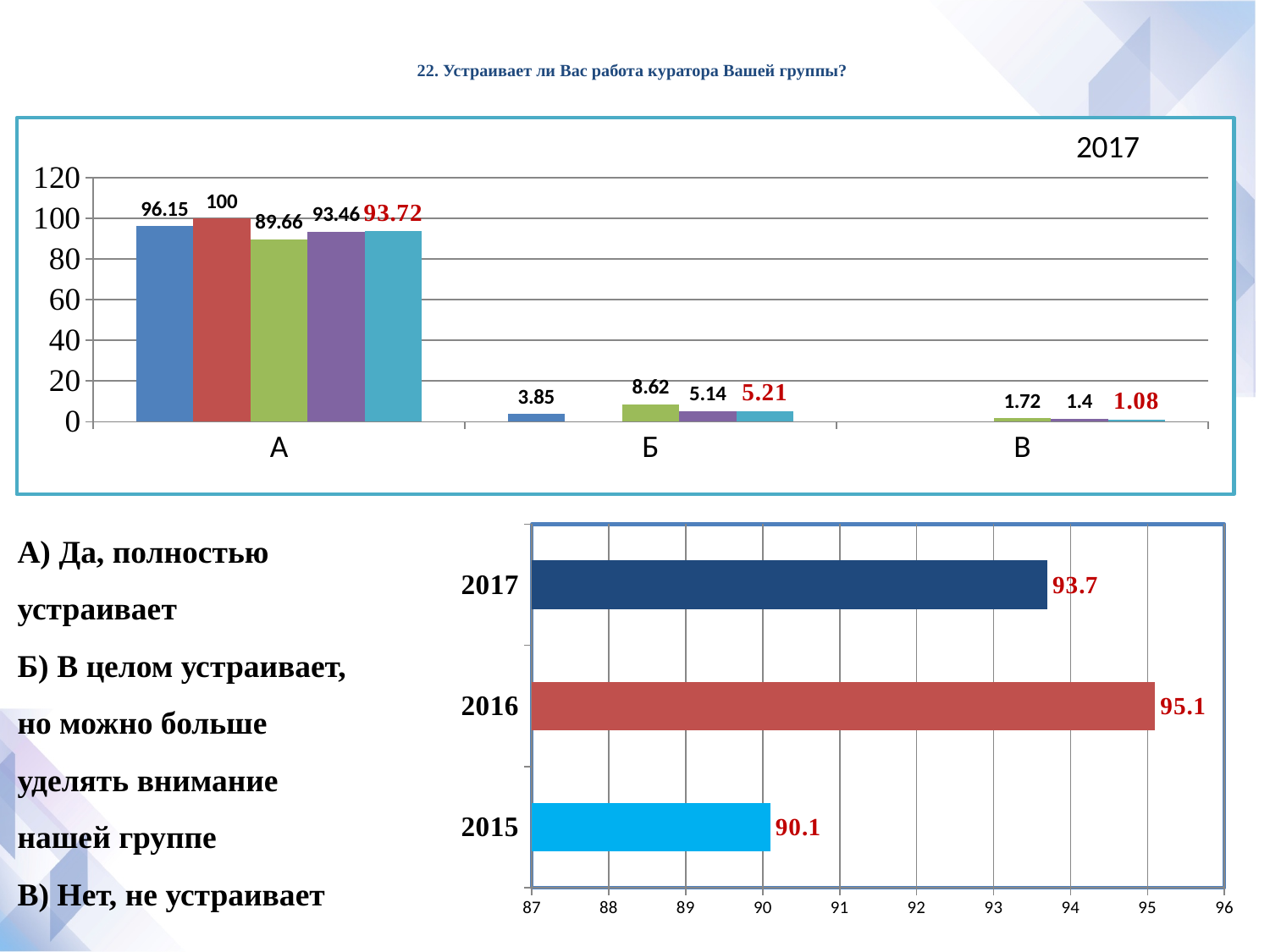
In the top chart, what is the highest value shown for category А? 100 In the top chart, how many categories are shown on the x axis? 3 What kind of chart is the bottom chart? bar chart In the bottom chart, how many years are shown? 3 In the bottom chart, which year has the highest value? 2016 In the top chart, what is the lowest value shown for category В? 1.08 In the bottom chart, what is the value for 2016? 95.1 In the bottom chart, what is the value for 2015? 90.1 In the bottom chart, which year has the lowest value? 2015 In the bottom chart, what is the value for 2017? 93.7 In the bottom chart, what is the difference between the values for 2016 and 2015? 5 In the bottom chart, which is larger, the value for 2017 or the value for 2016? 2016